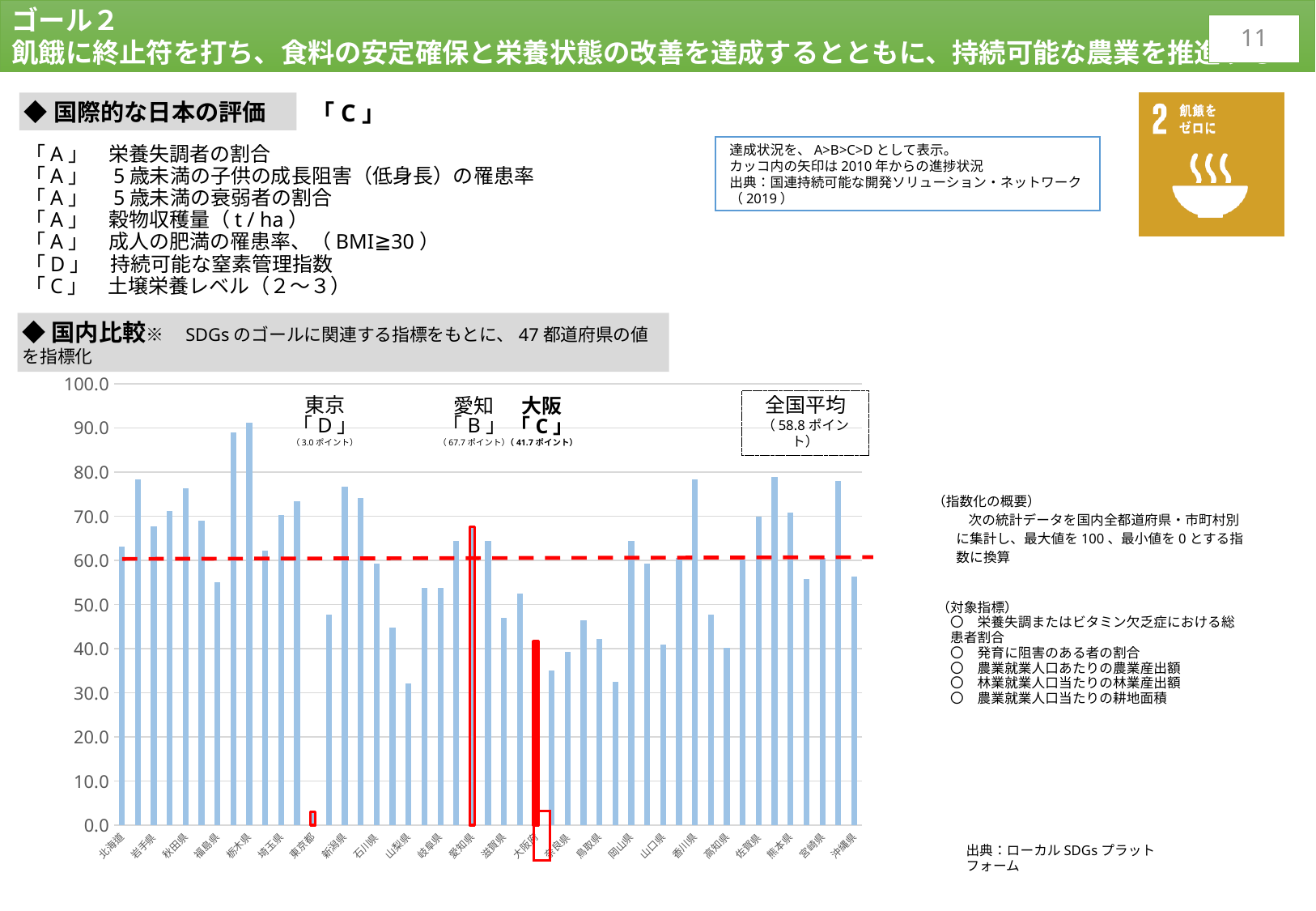
Which has the larger value on the chart, 愛知 or 大阪? 愛知 What is the difference between the printed values for 愛知 and 大阪? 26.0ポイント What is the 全国平均 value shown on the chart? 58.8ポイント What value is printed for 愛知 on the chart? 67.7ポイント What value is printed for 東京 on the chart? 3.0ポイント Which prefecture has the lowest bar on the chart? 東京都 Is the value for 岩手県 greater or less than 70? less Is the value for 山梨県 greater or less than 50? less What is the difference between the printed values for 大阪 and 東京? 38.7ポイント What kind of chart is shown in the 国内比較 section of the slide? bar chart What value is printed for 大阪 on the chart? 41.7ポイント